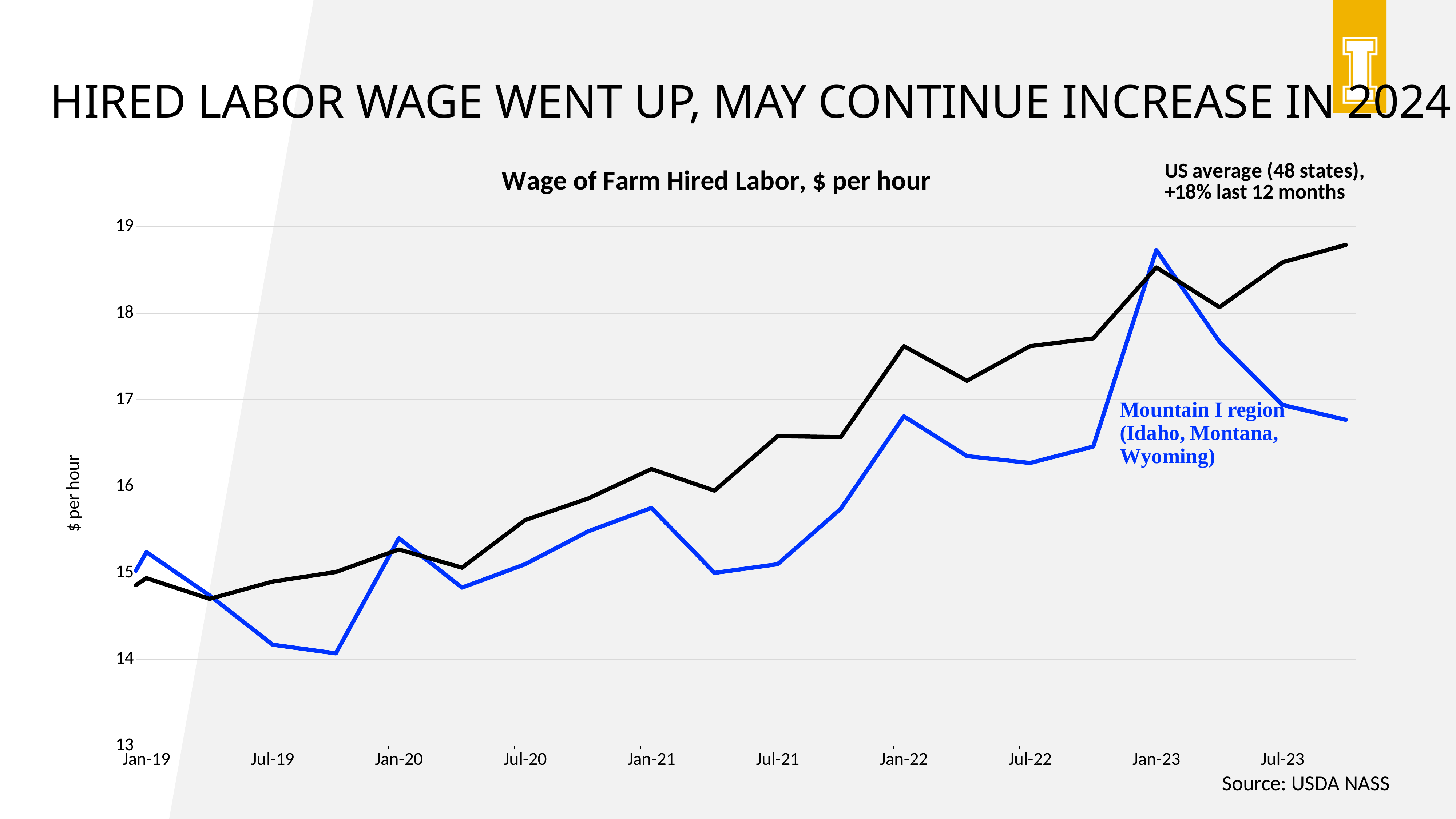
Is the Mountain I region wage at Jan-19 greater or less than 15? greater Is the US average wage at Jan-22 greater or less than 17? greater At Jul-23, which series has the higher wage: US average or Mountain I region? US average What is the source cited for the chart data? USDA NASS What is the title of the chart? Wage of Farm Hired Labor, $ per hour Does the US average wage generally rise or fall from Jan-19 to Jul-23? rise Is the US average wage at Jan-19 greater or less than 15? less At Jan-22, which series has the higher wage: US average or Mountain I region? US average What kind of chart is shown on the slide? line chart How many lines (series) are plotted on the chart? 2